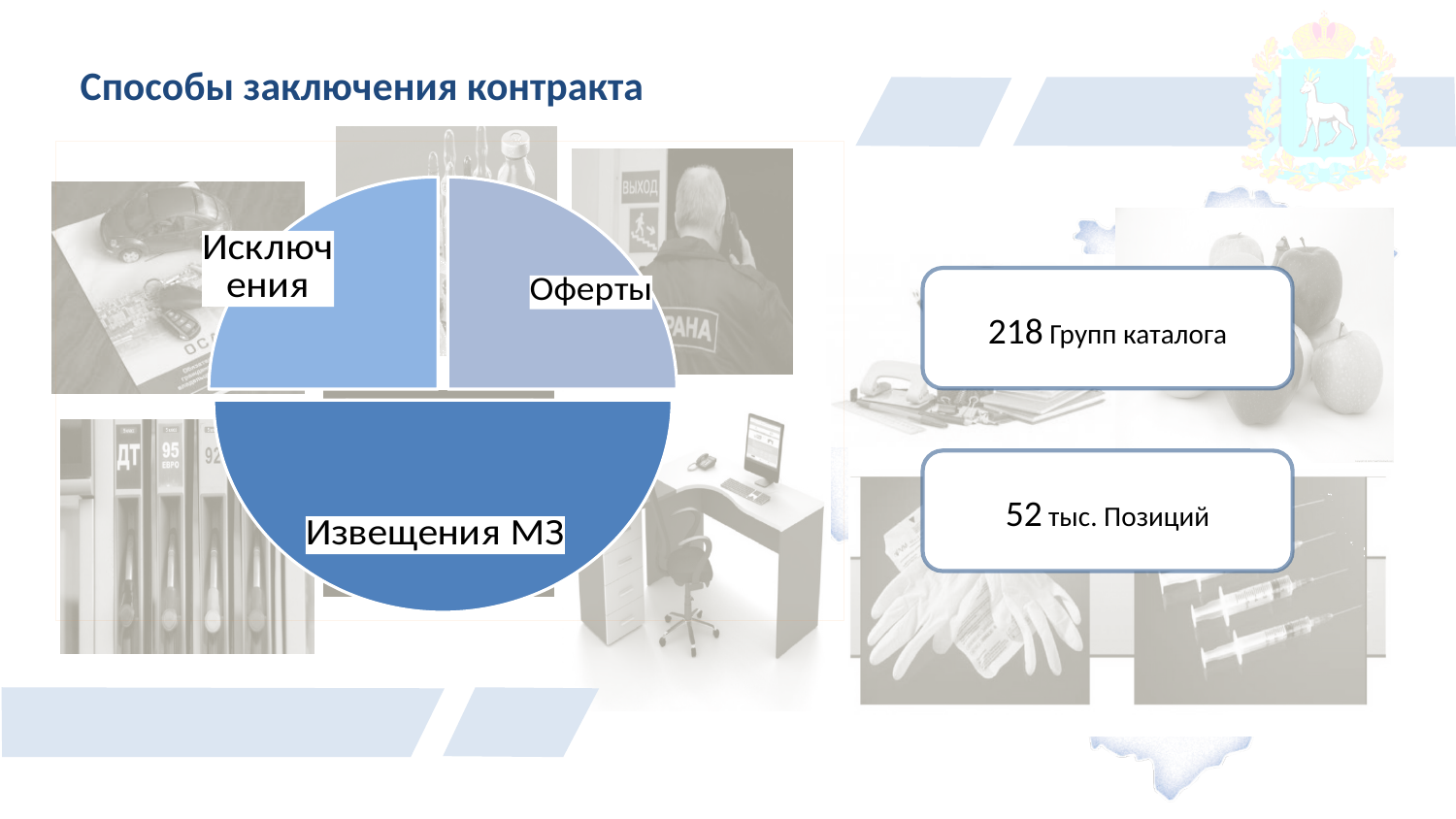
Which slice is larger, Извещения МЗ or Оферты? Извещения МЗ How many slices does the pie chart have? 3 Which slice is larger, Извещения МЗ or Исключения? Извещения МЗ What kind of chart is shown on the slide? pie chart What is the title of the slide containing the pie chart? Способы заключения контракта What are the labels of the three slices in the pie chart? Исключения, Оферты, Извещения МЗ Which slice of the pie chart is the largest? Извещения МЗ